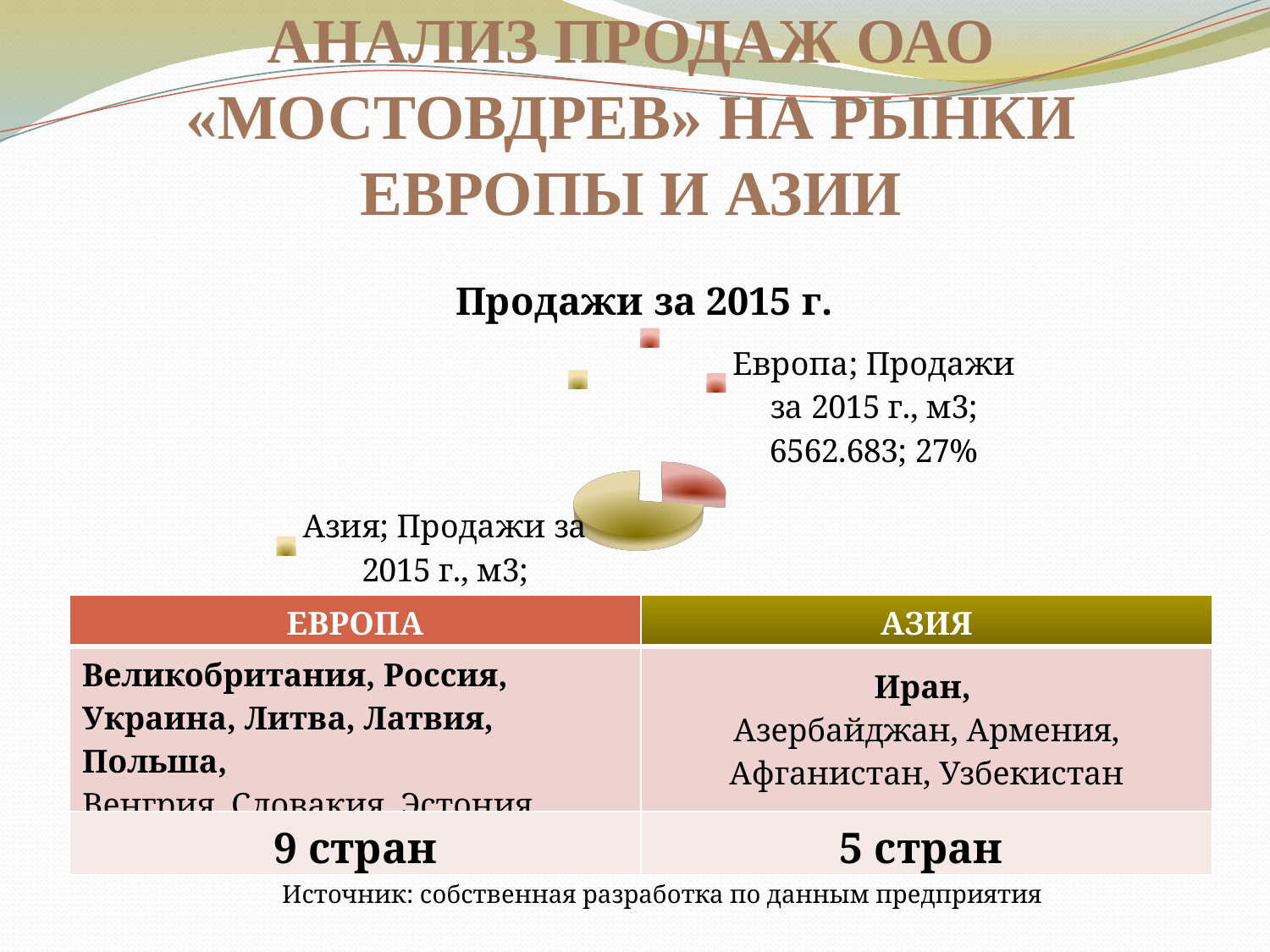
Which slice is larger, Европа or Азия? Азия How many slices does the pie chart have? 2 What is the sales value for Европа in the pie chart? 6562.683 What kind of chart is shown on the slide? pie chart Which slice of the pie chart is the smallest? Европа What colour is the Европа slice in the pie chart? red Which slice of the pie chart is the largest? Азия Is the share of the Европа slice greater or less than 50%? less In what unit are the sales values in the pie chart given? м3 What share of the pie does the Европа slice represent? 27% What is the title of the chart? Продажи за 2015 г.